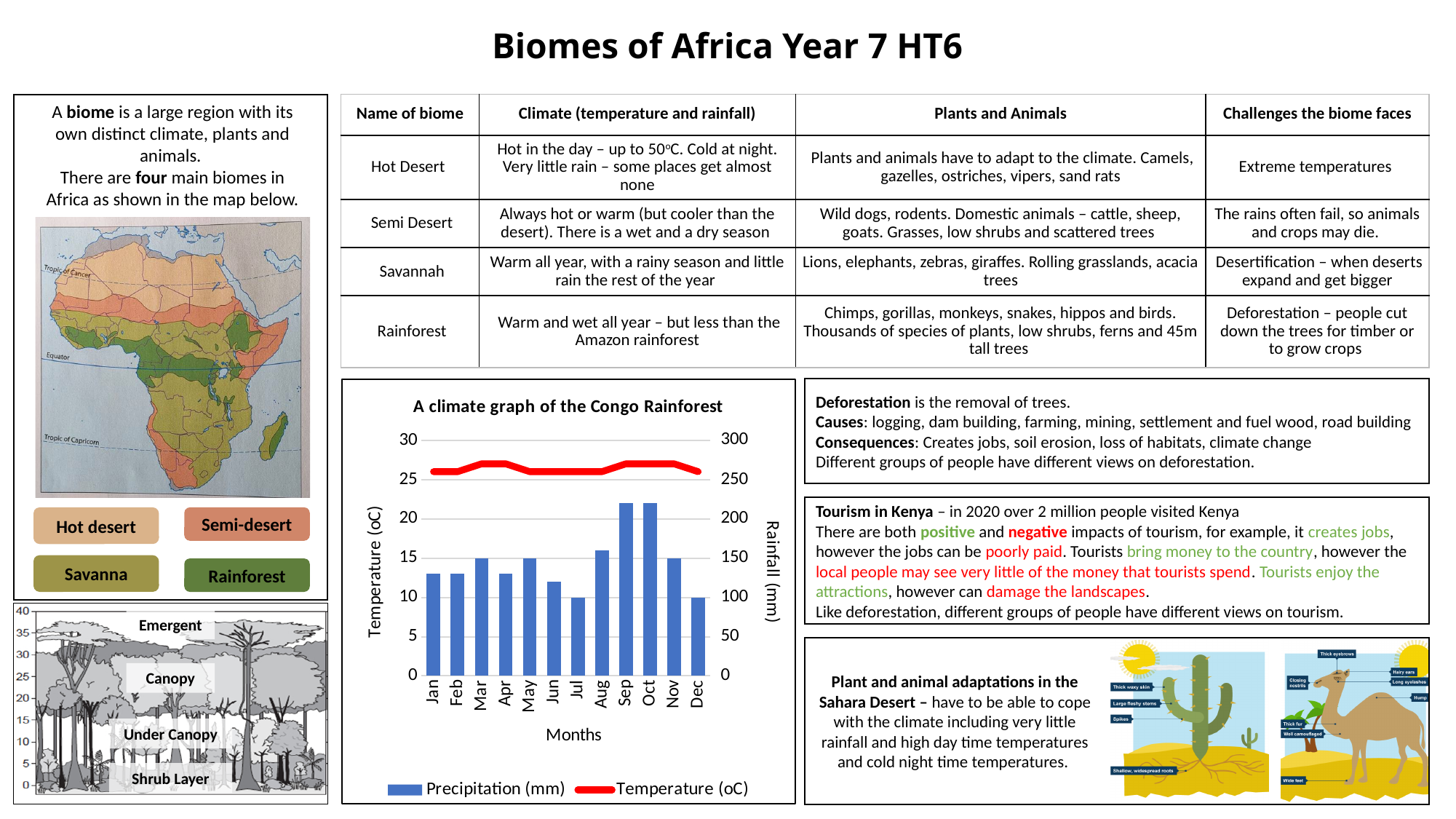
In the climate graph, which series is shown as blue bars? Precipitation (mm) In the climate graph, which month has the higher precipitation, Jul or Aug? Aug In the climate graph, which month has the higher precipitation, Sep or Jan? Sep In the climate graph, is the temperature for Jan greater or less than 25 oC? greater In the climate graph, is the temperature for Jul greater or less than 30 oC? less How many series does the legend of the climate graph list? 2 In the climate graph, is the precipitation for Sep greater or less than 200 mm? greater What is the label on the right-hand vertical axis of the climate graph? Rainfall (mm) What is the title of the chart on the slide? A climate graph of the Congo Rainforest How many months are plotted along the x axis of the climate graph? 12